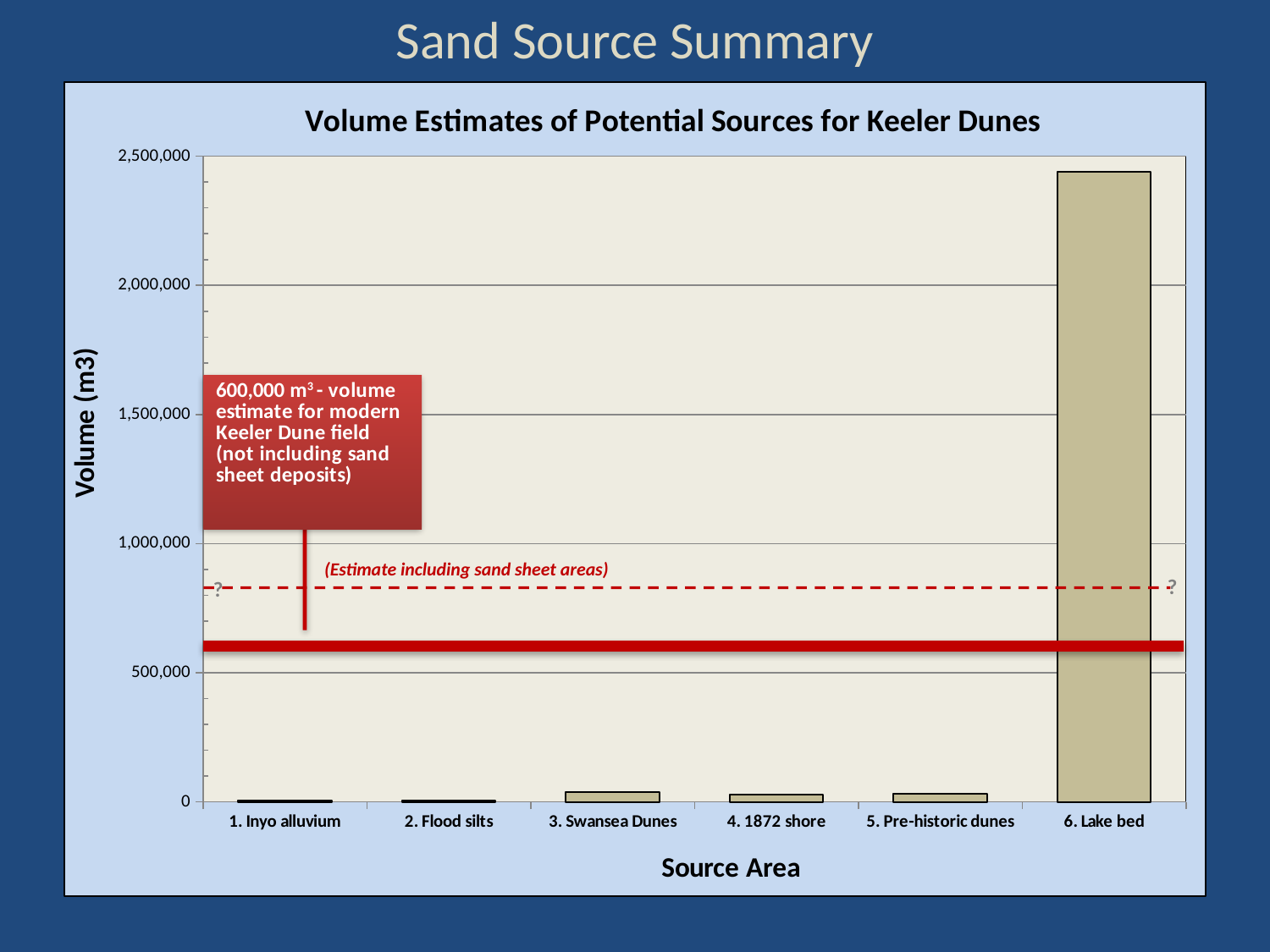
What is the label of the x axis? Source Area Which is larger, the value for 6. Lake bed or the value for 4. 1872 shore? 6. Lake bed What is the title of the chart? Volume Estimates of Potential Sources for Keeler Dunes What is the label of the y axis? Volume (m3) Which source area has the highest volume estimate? 6. Lake bed Is the value for 6. Lake bed greater or less than 2,000,000? greater What kind of chart is shown on the slide? bar chart How many source areas are plotted on the x axis? 6 What volume estimate for the modern Keeler Dune field is given in the red annotation box? 600,000 m³ Is the value for 5. Pre-historic dunes greater or less than 500,000? less Is the value for 3. Swansea Dunes greater or less than 500,000? less